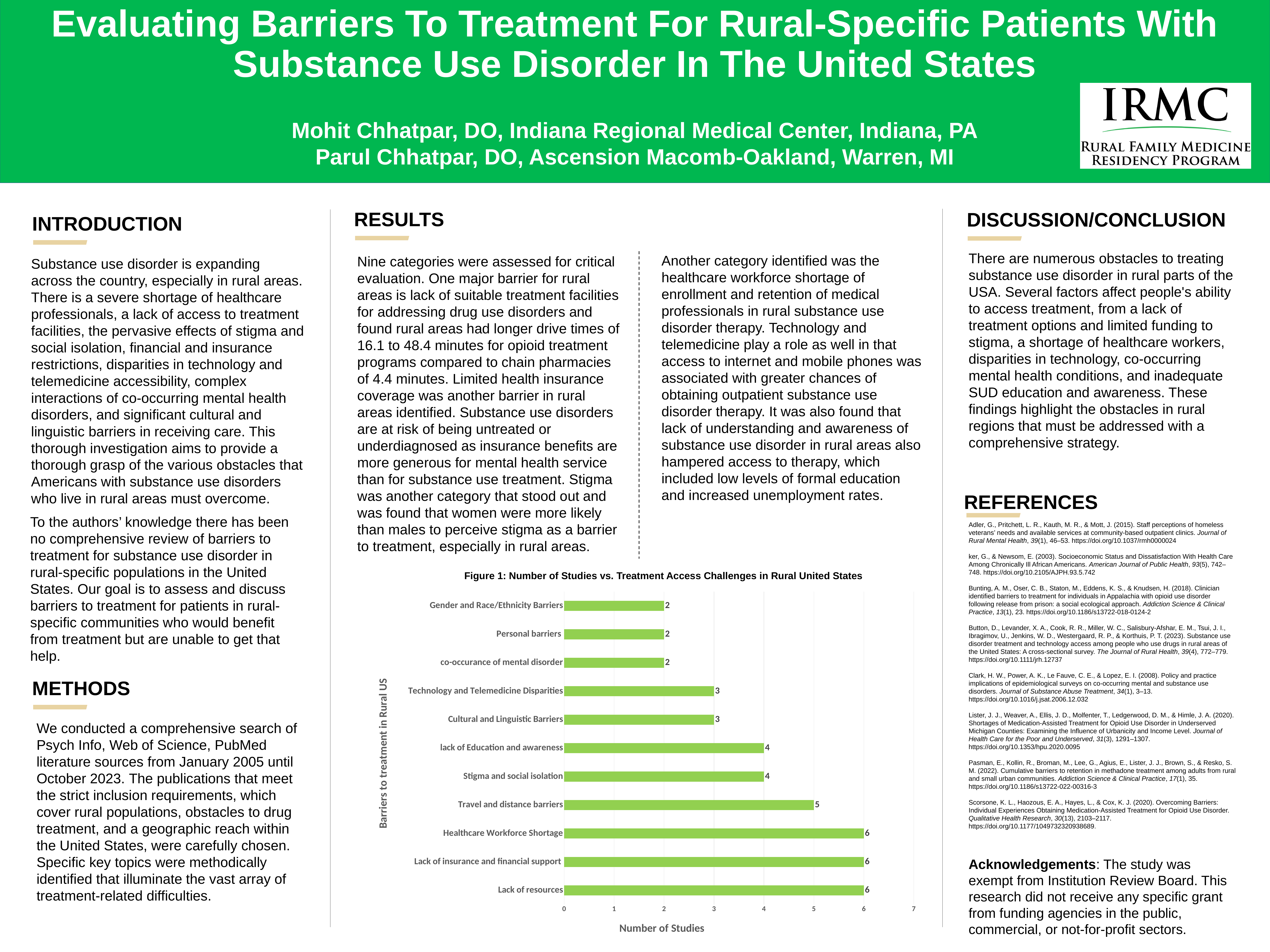
What is the title of the chart? Figure 1: Number of Studies vs. Treatment Access Challenges in Rural United States What is the title of the x axis of the chart? Number of Studies Which has more studies, lack of Education and awareness or co-occurance of mental disorder? lack of Education and awareness What is the number of studies for Healthcare Workforce Shortage? 6 Which has more studies, Travel and distance barriers or Cultural and Linguistic Barriers? Travel and distance barriers How many barrier categories are plotted in the chart? 11 What is the number of studies for Technology and Telemedicine Disparities? 3 What is the difference in number of studies between Lack of resources and Gender and Race/Ethnicity Barriers? 4 How many studies are shown for Travel and distance barriers? 5 What is the number of studies for Stigma and social isolation? 4 What type of chart is Figure 1? bar chart How many studies are shown for Personal barriers? 2